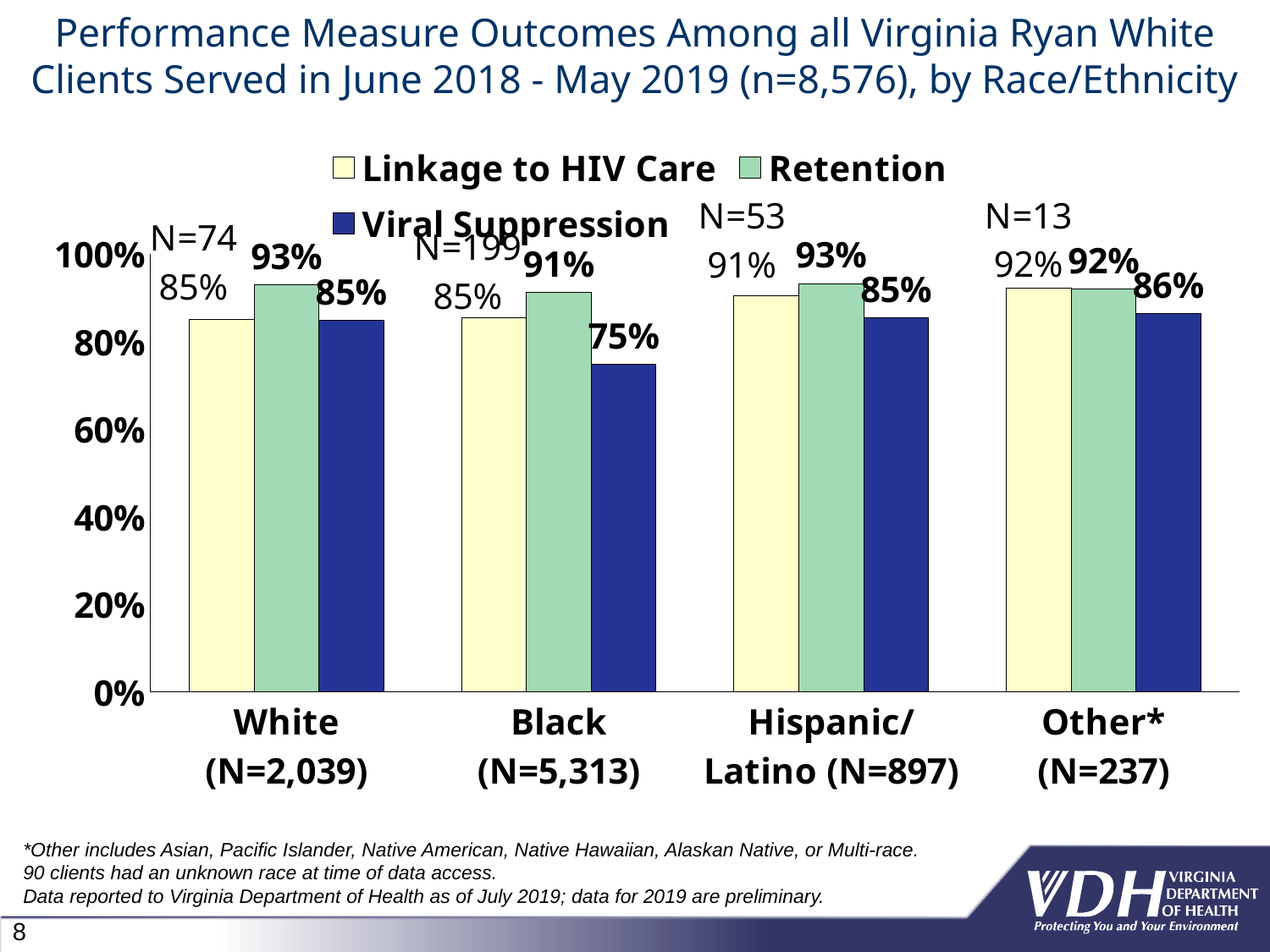
Is the Viral Suppression value for White (N=2,039) larger or smaller than the Viral Suppression value for Black (N=5,313)? larger What is the Retention value for White (N=2,039)? 93% How many series does the legend list? 3 Which race/ethnicity group has the lowest Viral Suppression value? Black (N=5,313) What is the Viral Suppression value for Black (N=5,313)? 75% What is the Viral Suppression value for Other* (N=237)? 86% How many race/ethnicity categories are shown on the x axis? 4 What is the difference between the Retention and Viral Suppression values for Black (N=5,313)? 16% Which race/ethnicity group has the highest Linkage to HIV Care value? Other* (N=237) Which series is shown in dark blue in the legend? Viral Suppression What kind of chart is shown on the slide? bar chart What is the Linkage to HIV Care value for Hispanic/Latino (N=897)? 91%